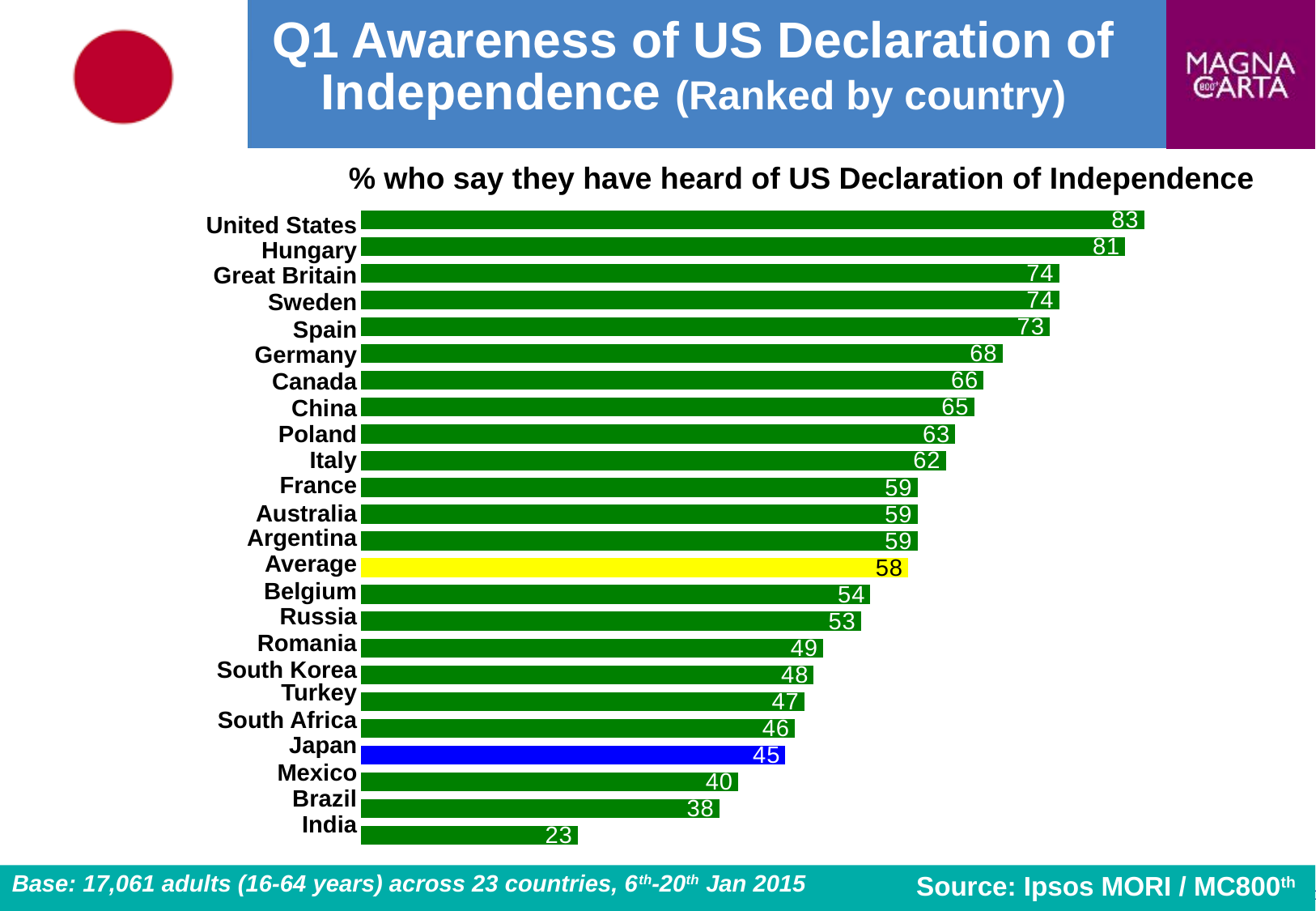
What is the difference between the values for the United States and India? 60 Which has a higher value, Mexico or Brazil? Mexico What colour is the bar for Japan? Blue What kind of chart is shown on the slide? Bar chart How many percentage points is Japan below the Average? 13 Which has a higher value, Germany or Canada? Germany What is the Average value shown on the chart? 58 What percentage of people in Japan say they have heard of the US Declaration of Independence? 45 Which country has the highest awareness of the US Declaration of Independence? United States What is the value shown for Hungary? 81 Which country has the lowest awareness of the US Declaration of Independence? India How many bars are shown on the chart, including the Average? 24